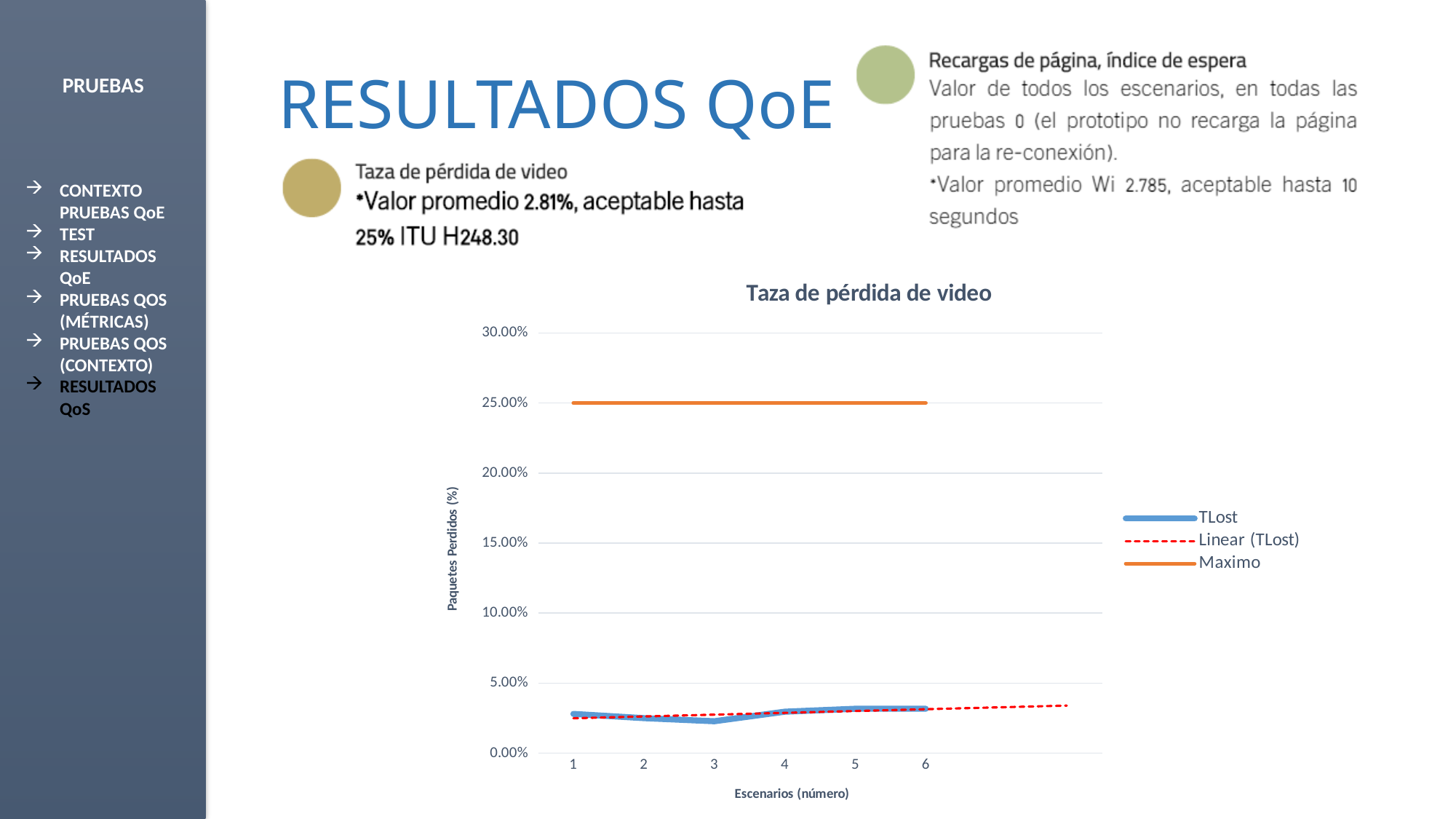
How many scenarios (escenarios) are shown on the x axis of the chart? 6 What are the series names listed in the chart legend? TLost, Linear (TLost), Maximo What type of chart is shown on the slide? line chart Is the TLost value for scenario 3 greater or less than 5.00%? less How many series does the chart legend list? 3 At scenario 1, which series has the larger value, Maximo or TLost? Maximo Is the Maximo value greater or less than 20.00%? greater At which scenario is the TLost series lowest? 3 Does the Linear (TLost) trend line rise or fall from scenario 1 to scenario 6? rise Is the TLost value for scenario 6 greater or less than 10.00%? less What is the value of the Maximo series in the chart? 25.00% What is the title of the chart? Taza de pérdida de video